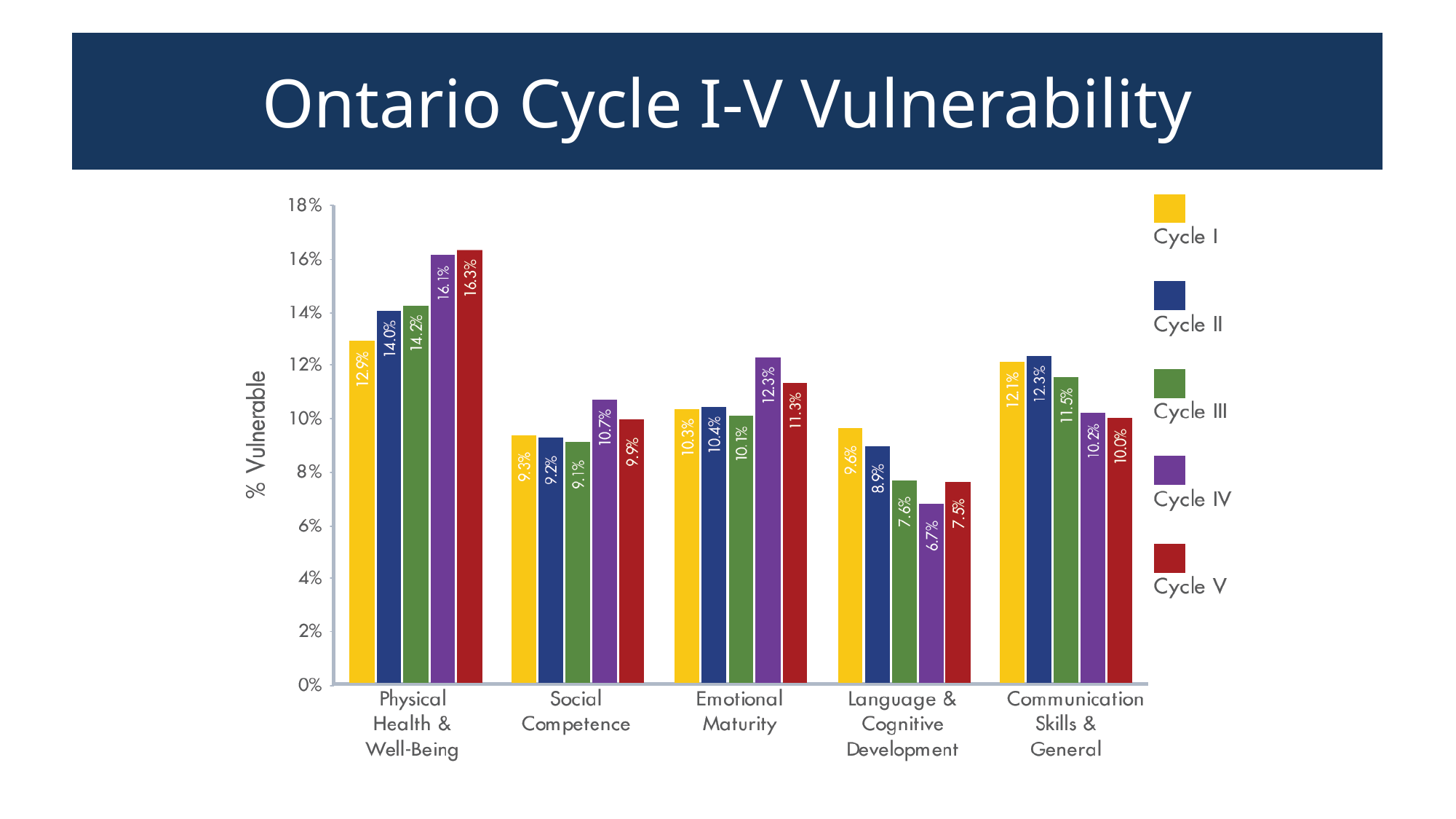
What is the Cycle IV value for Language & Cognitive Development? 6.7% How many categories are shown on the x axis? 5 How many series does the legend list? 5 What is the label of the y axis? % Vulnerable What kind of chart is shown on the slide? bar chart What is the difference between the Cycle V and Cycle I values for Physical Health & Well-Being? 3.4% What is the Cycle I value for Communication Skills & General? 12.1% Which is larger for Emotional Maturity: the Cycle IV value or the Cycle I value? Cycle IV Which category has the lowest Cycle IV value? Language & Cognitive Development Which category has the highest Cycle V value? Physical Health & Well-Being What is the Cycle V value for Physical Health & Well-Being? 16.3% Is the Cycle III value for Social Competence greater or less than 10%? less